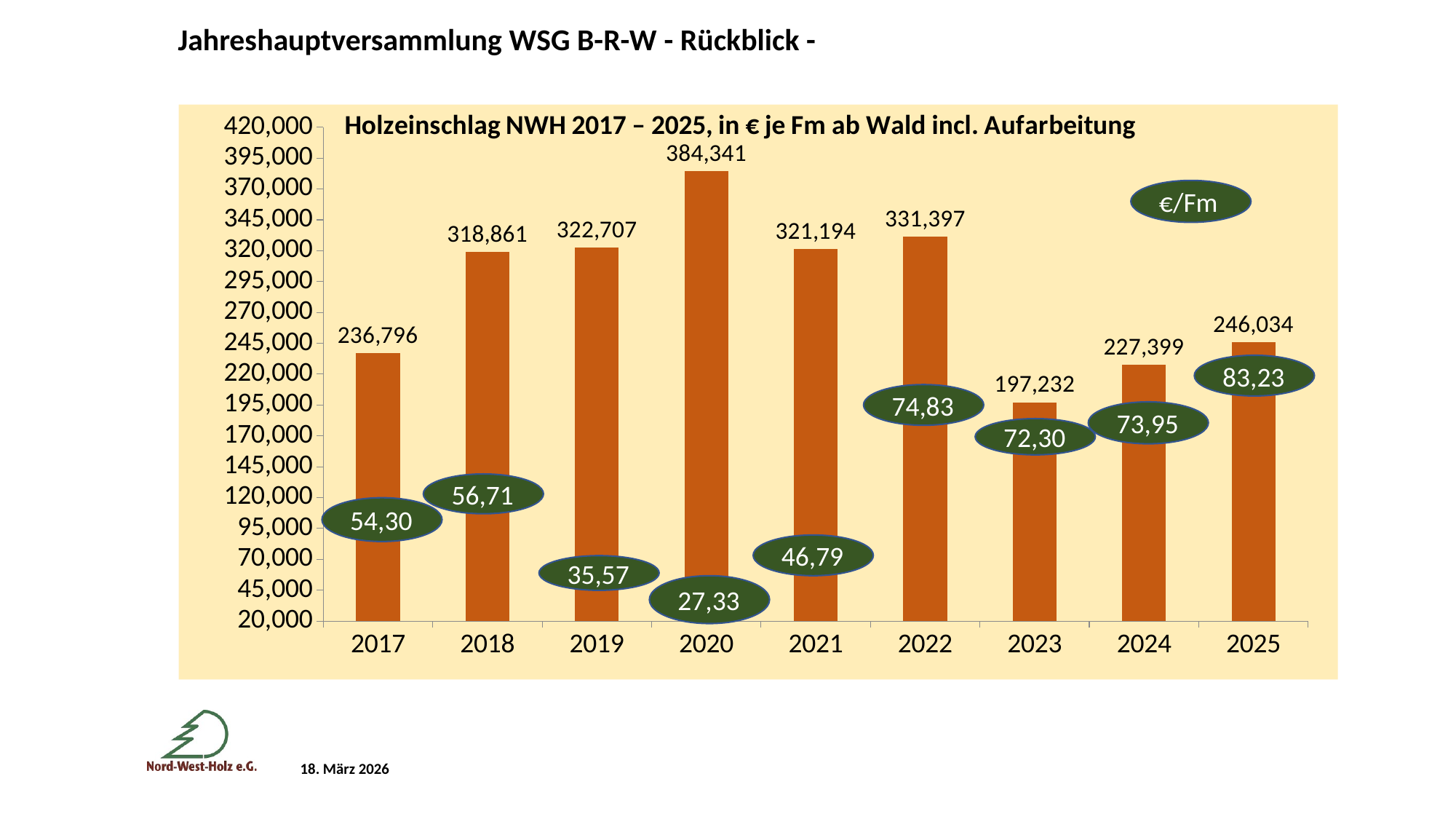
Is the value for 2017 greater or less than 245,000? less What kind of chart is shown? bar chart What is the difference between the values for 2025 and 2024? 18,635 What is the difference between the values for 2020 and 2023? 187,109 Which year has the highest value? 2020 Do the values rise or fall from 2023 to 2025? rise What is the value for 2017? 236,796 Which year has the lowest value? 2023 Which is larger, the value for 2022 or the value for 2021? 2022 How many years are shown on the x axis? 9 What is the value for 2023? 197,232 What is the value for 2020? 384,341